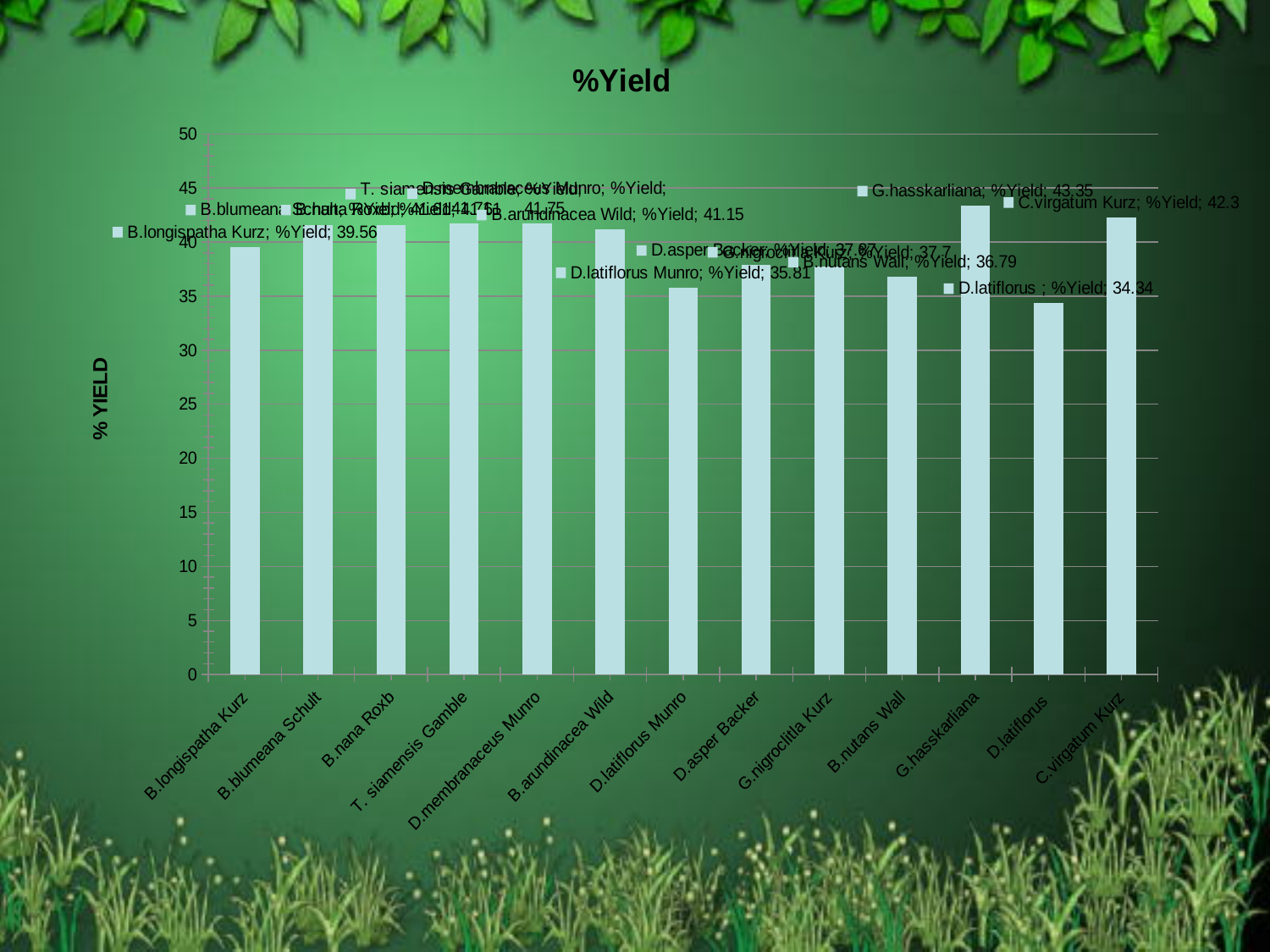
Which has a higher %Yield, C.virgatum Kurz or B.nutans Wall? C.virgatum Kurz What is the %Yield value for D.latiflorus Munro? 35.81 What is the %Yield value for B.nutans Wall? 36.79 What is the difference in %Yield between G.hasskarliana and D.latiflorus? 9.01 What is the %Yield value for B.longispatha Kurz? 39.56 Which species has the lowest %Yield? D.latiflorus What is the %Yield value for G.hasskarliana? 43.35 How many species are shown on the x axis of the chart? 13 Is the %Yield value for B.nana Roxb greater or less than 40? greater What type of chart is shown on the slide? Bar chart What is the %Yield value for C.virgatum Kurz? 42.3 Which species has the highest %Yield? G.hasskarliana